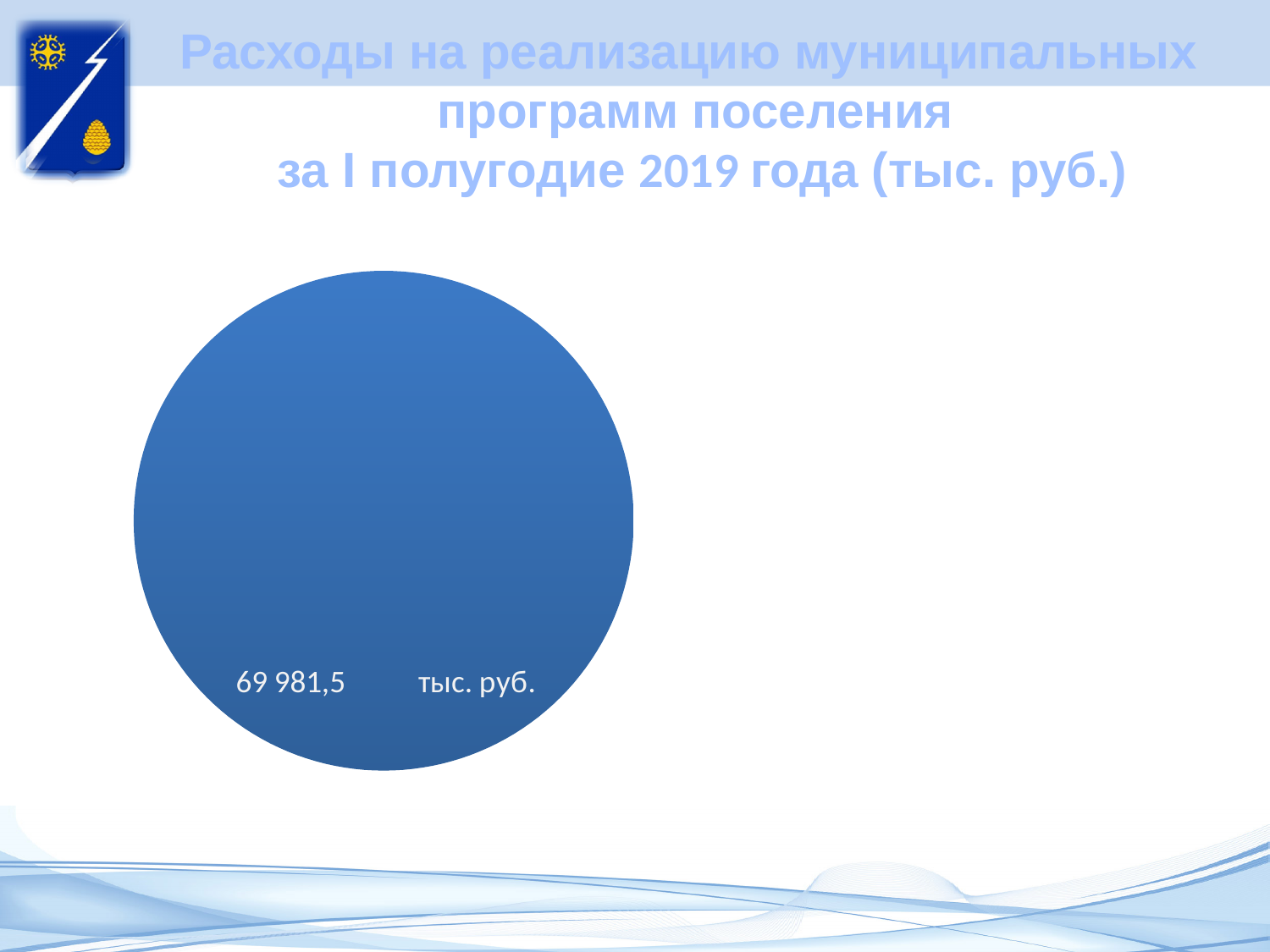
In what units are the expenses on the pie chart expressed? тыс. руб. What value is printed on the pie chart? 69 981,5 тыс. руб. What is the title of the slide containing the pie chart? Расходы на реализацию муниципальных программ поселения за I полугодие 2019 года (тыс. руб.) How many slices does the pie chart contain? 1 What share of the pie does the single slice represent? 100% What colour is the pie chart? blue What kind of chart is shown on the slide? pie chart